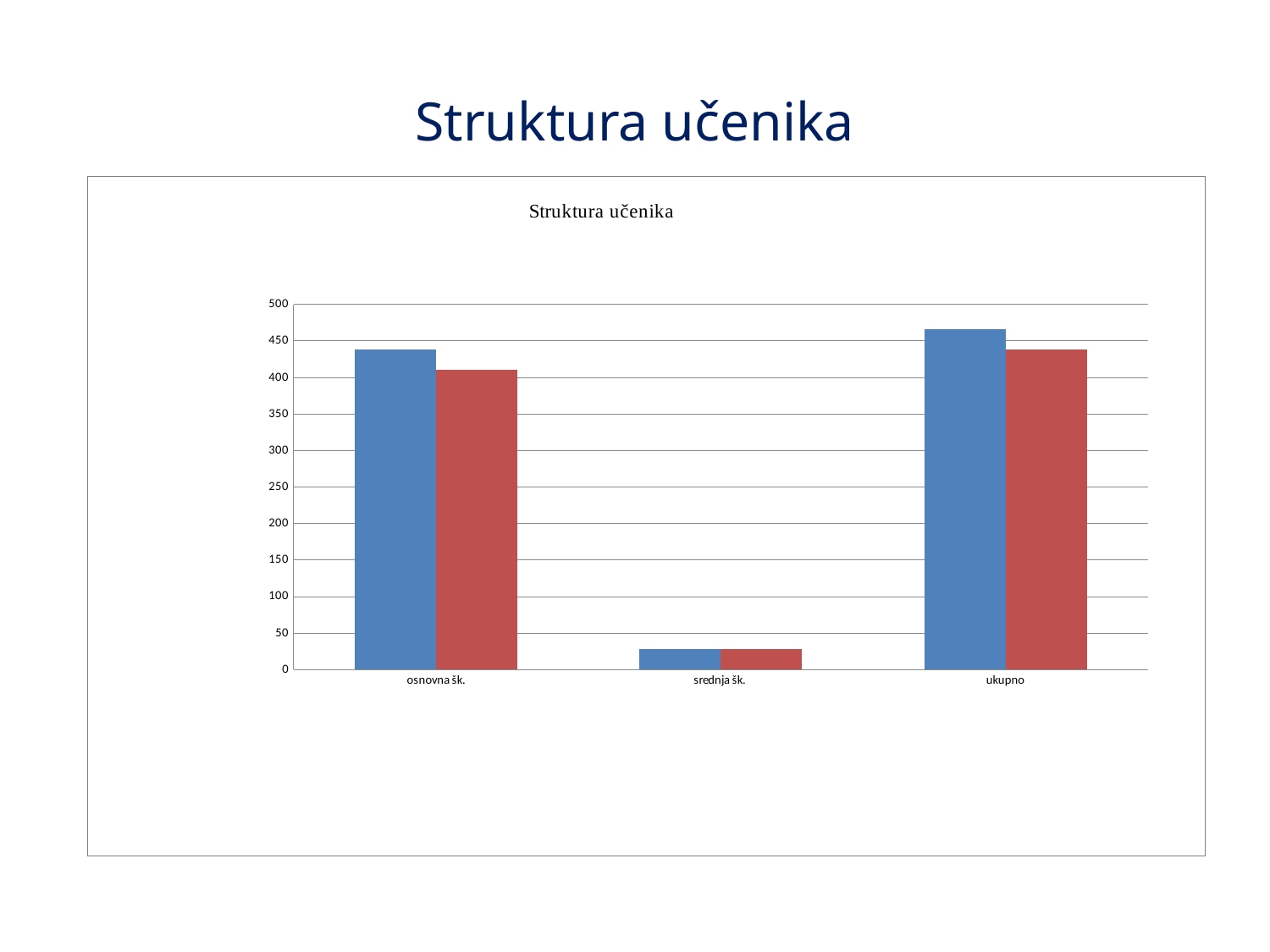
How many bars are plotted for each category in the chart? 2 Which category has the tallest blue bar? ukupno Is the blue bar for srednja šk. greater or less than 50? less Which category has the shortest red bar? srednja šk. Is the red bar for ukupno greater or less than 400? greater Is the blue bar for ukupno greater or less than 450? greater How many categories are shown on the x axis of the chart? 3 What is the title of the chart? Struktura učenika What type of chart is shown on the slide? bar chart For osnovna šk., which bar is taller, the blue one or the red one? the blue one Which category has the shortest blue bar? srednja šk.